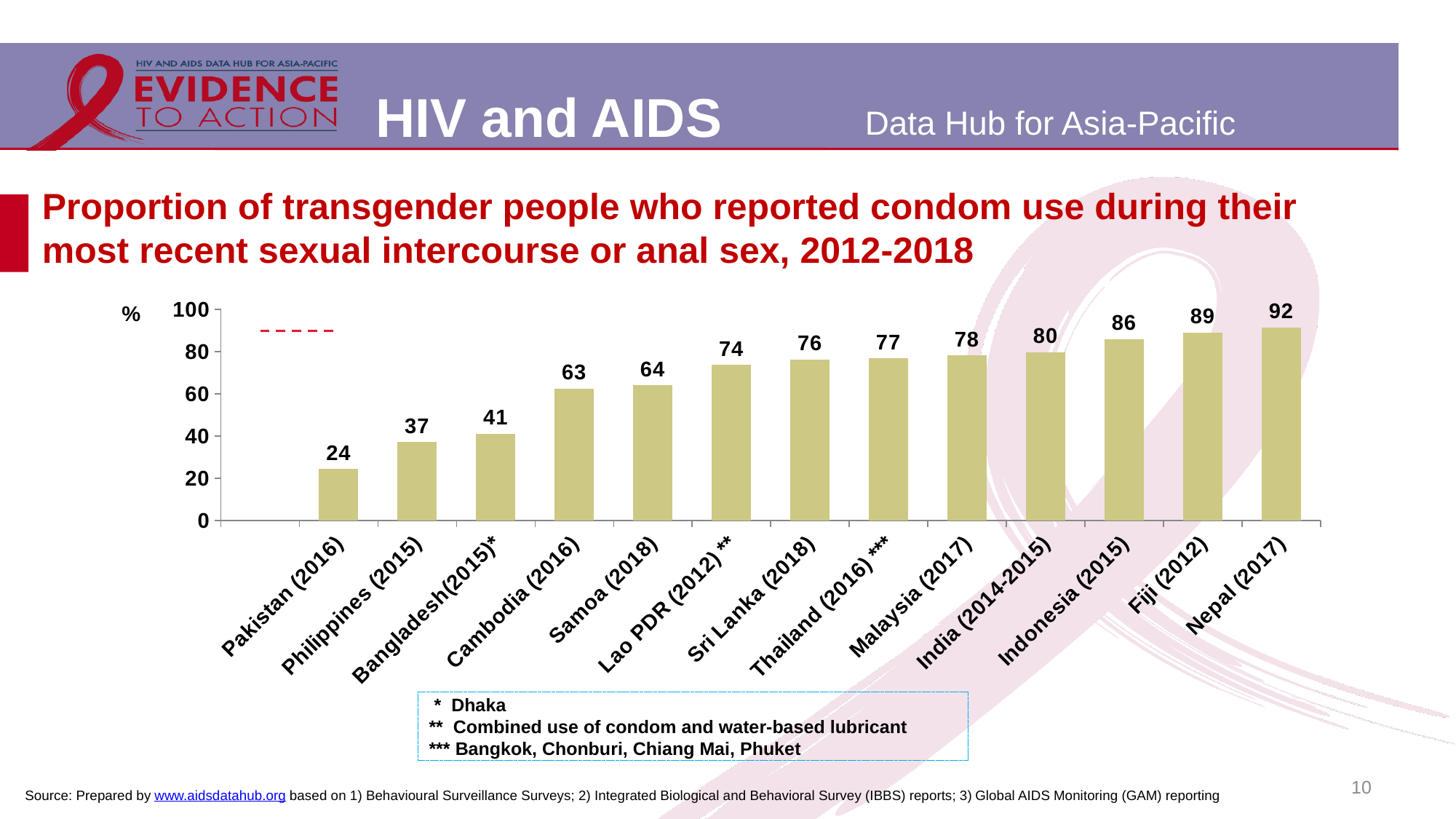
What kind of chart is shown on the slide? bar chart Is the value for Malaysia (2017) greater or less than 60? greater What is the value for Pakistan (2016)? 24 How many categories are shown on the x axis? 13 What is the value for Indonesia (2015)? 86 Which category has the highest value? Nepal (2017) Do the values rise or fall from left to right along the x axis? rise What is the difference between the values for Fiji (2012) and Cambodia (2016)? 26 Which category has the lowest value? Pakistan (2016) What is the value for Sri Lanka (2018)? 76 What is the difference between the values for Nepal (2017) and Pakistan (2016)? 68 Which is larger, the value for Philippines (2015) or the value for Bangladesh(2015)*? Bangladesh(2015)*